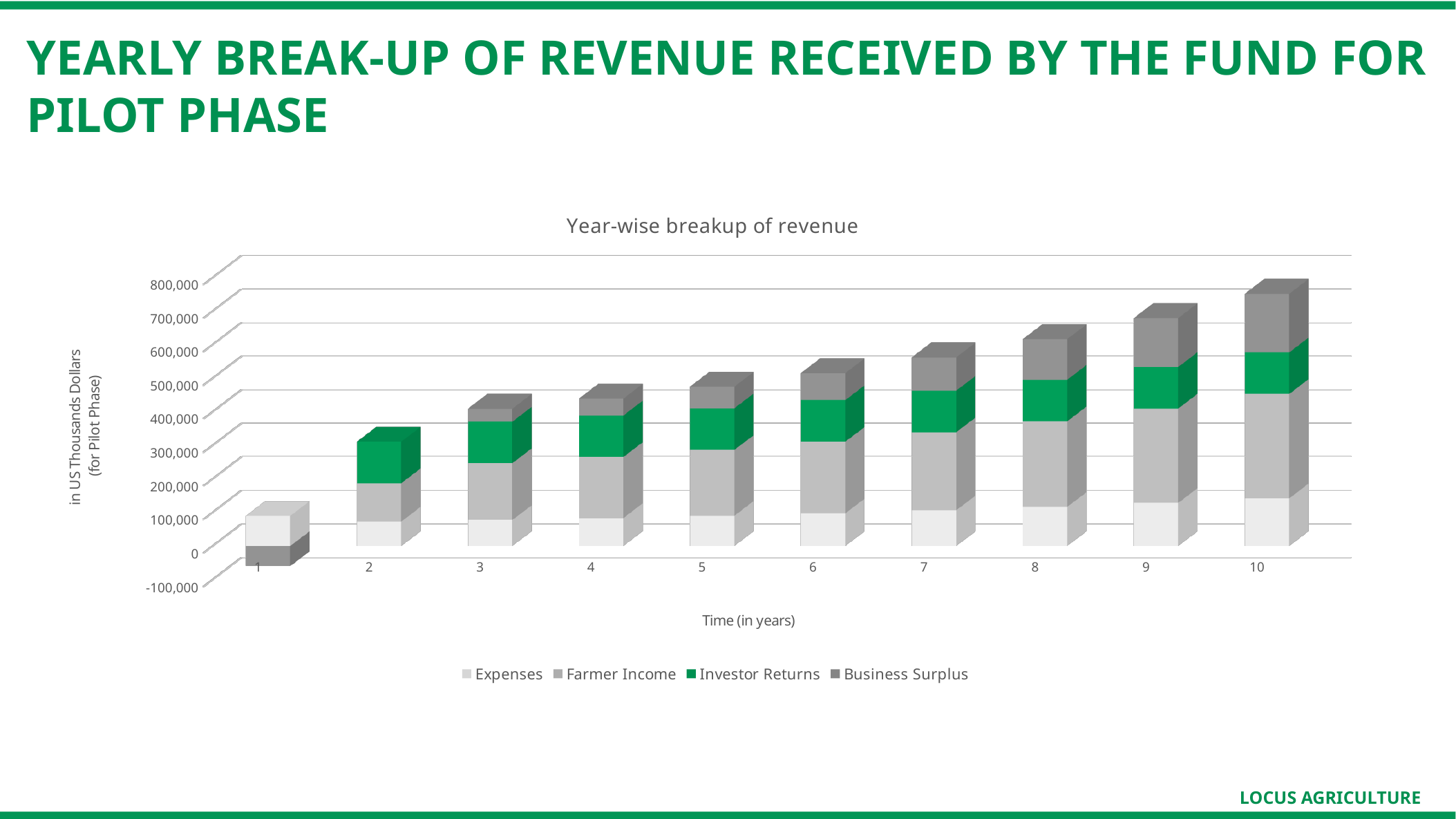
What is the title of the chart? Year-wise breakup of revenue Which year has the tallest stacked bar in the chart? 10 Which series in the chart is shown in green? Investor Returns Which year has the larger total bar, year 3 or year 8? 8 How many years (categories) are plotted on the x axis of the chart? 10 What kind of chart is shown on the slide? Stacked bar chart Is the total bar height for year 5 greater or less than 400,000? greater Is the total bar height for year 10 greater or less than 700,000? greater Do the total bar heights rise or fall as the years increase from 1 to 10? Rise Which year has the shortest stacked bar in the chart? 1 How many series does the chart's legend list? 4 Is the total bar height for year 2 greater or less than 400,000? less